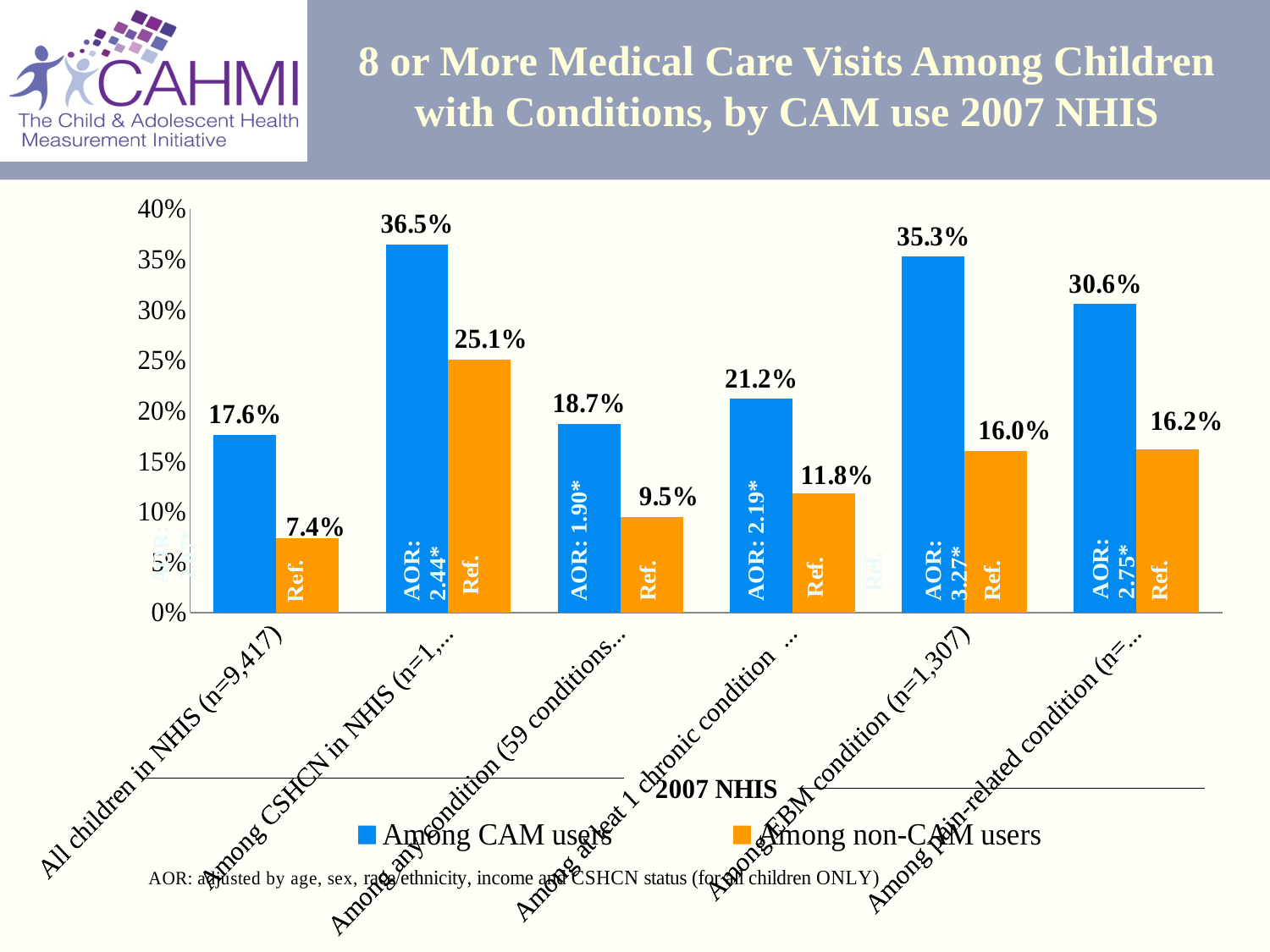
What is the value for 'Among non-CAM users' for the Among EBM condition (n=1,307) category? 16.0% What kind of chart is shown on the slide? Bar chart How many series does the legend list? 2 Which is larger for the Among EBM condition (n=1,307) category: the 'Among CAM users' value or the 'Among non-CAM users' value? Among CAM users How many categories are shown on the x axis? 6 What colour are the 'Among non-CAM users' bars? Orange What is the value for 'Among CAM users' for the Among EBM condition (n=1,307) category? 35.3% Which category has the highest value for 'Among CAM users'? Among CSHCN in NHIS Which category has the lowest value for 'Among non-CAM users'? All children in NHIS (n=9,417) What is the value for 'Among CAM users' for All children in NHIS (n=9,417)? 17.6% What is the difference between the 'Among CAM users' and 'Among non-CAM users' values for All children in NHIS (n=9,417)? 10.2% What is the value for 'Among non-CAM users' for All children in NHIS (n=9,417)? 7.4%